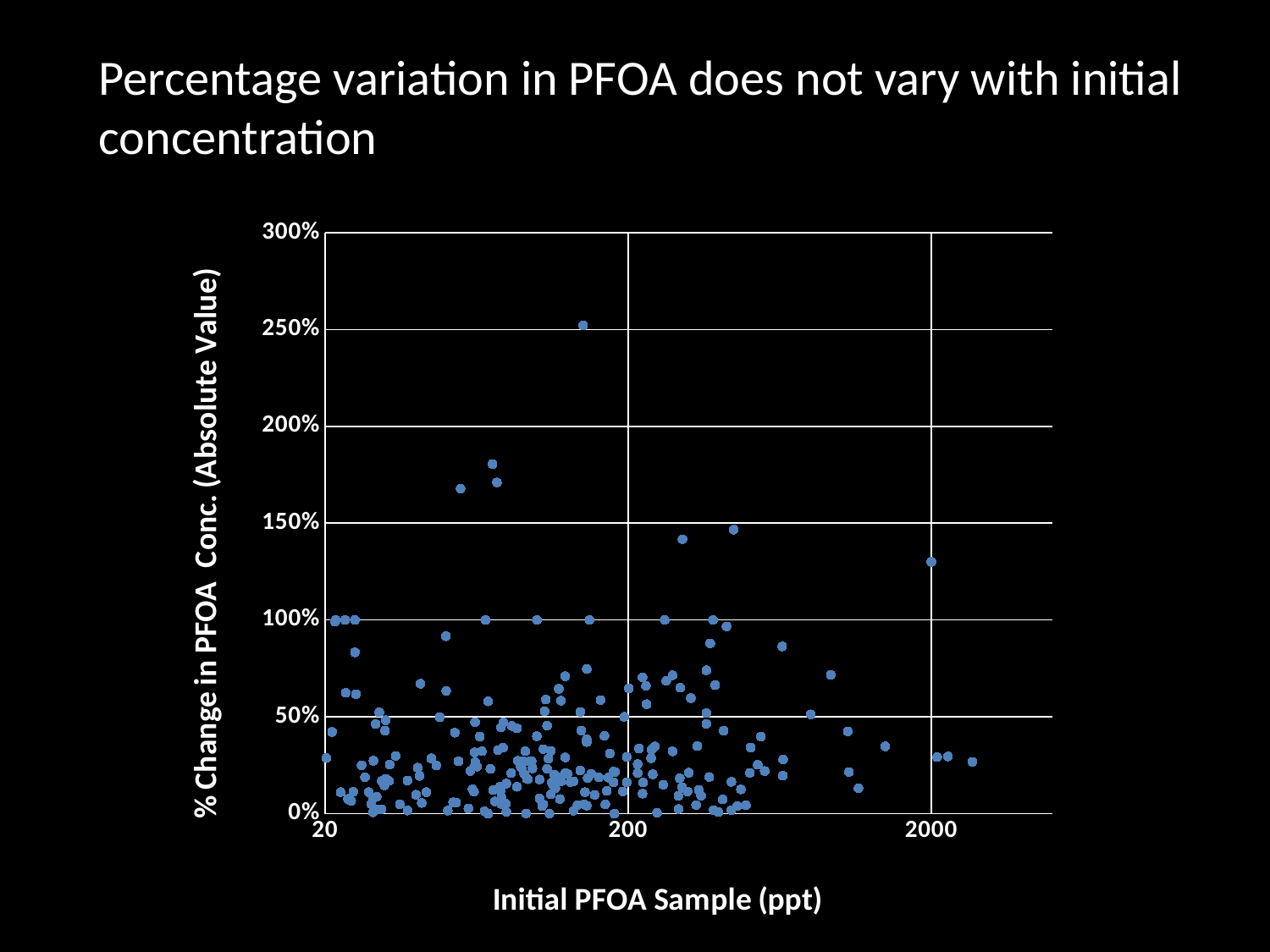
Do the plotted values show a clear rising or falling trend as the initial PFOA sample increases along the x axis? no clear trend What is the title of the slide's chart? Percentage variation in PFOA does not vary with initial concentration What colour are the plotted points? blue What is the highest tick value shown on the y axis? 300% Is the value of the highest point on the chart greater or less than 300%? less Is the value of the highest point on the chart greater or less than 200%? greater Is the value of the point plotted at about 2000 ppt on the x axis greater or less than 100%? greater What kind of chart is shown on the slide? scatter plot